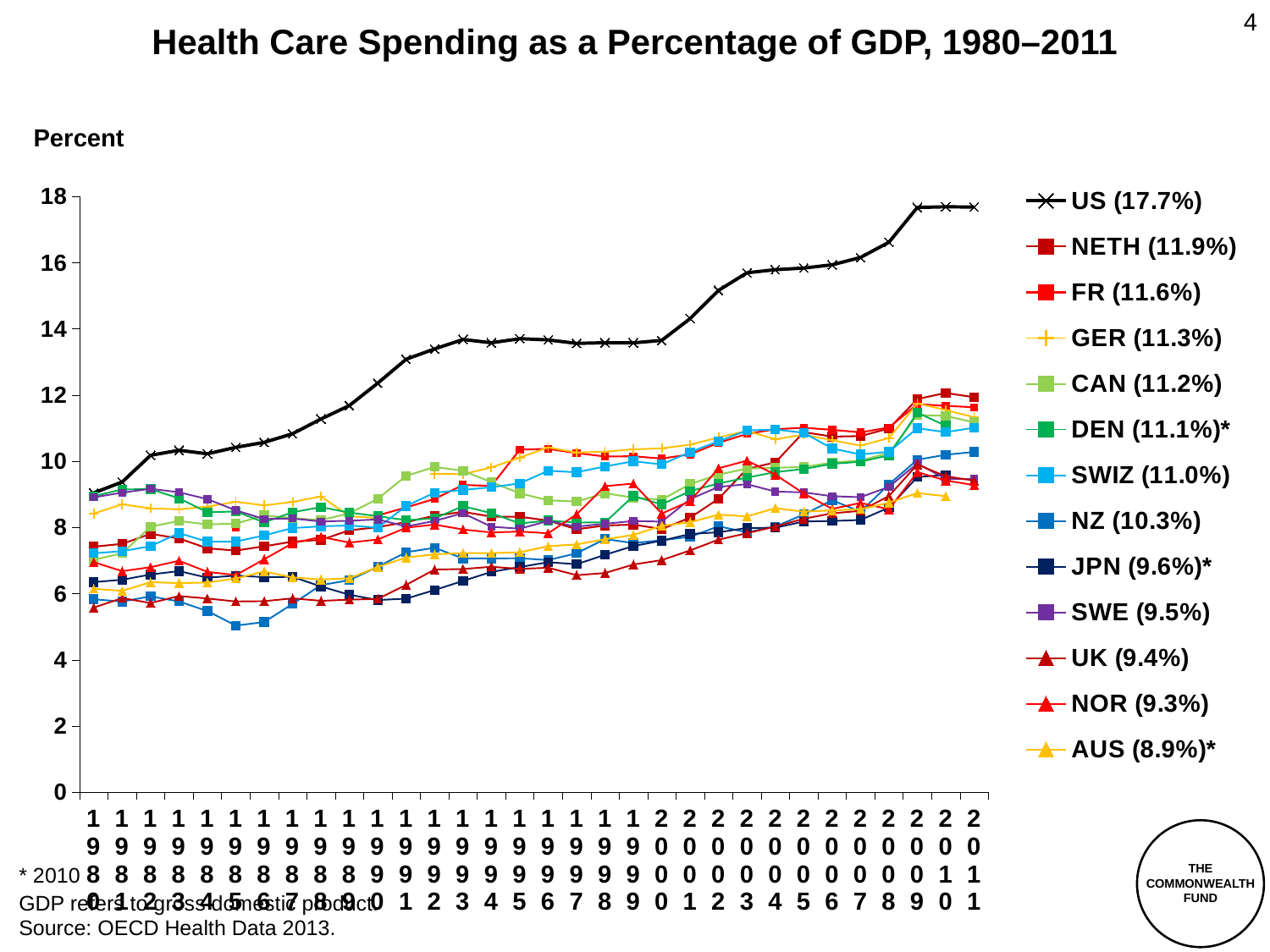
How many series does the legend list? 13 What percentage does the legend give for AUS? 8.9% Does the US line generally rise or fall from 1980 to 2011? rise Which has the larger legend percentage, NETH or FR? NETH What percentage does the legend give for US? 17.7% What is the difference between the legend percentages for US and NETH? 5.8% Which country has the lowest percentage shown in the legend? AUS Which country has the highest percentage shown in the legend? US How many years are plotted along the x axis? 32 Is the value for US in 1980 greater or less than 10? less What kind of chart is shown on the slide? line chart What is the title of the chart? Health Care Spending as a Percentage of GDP, 1980–2011